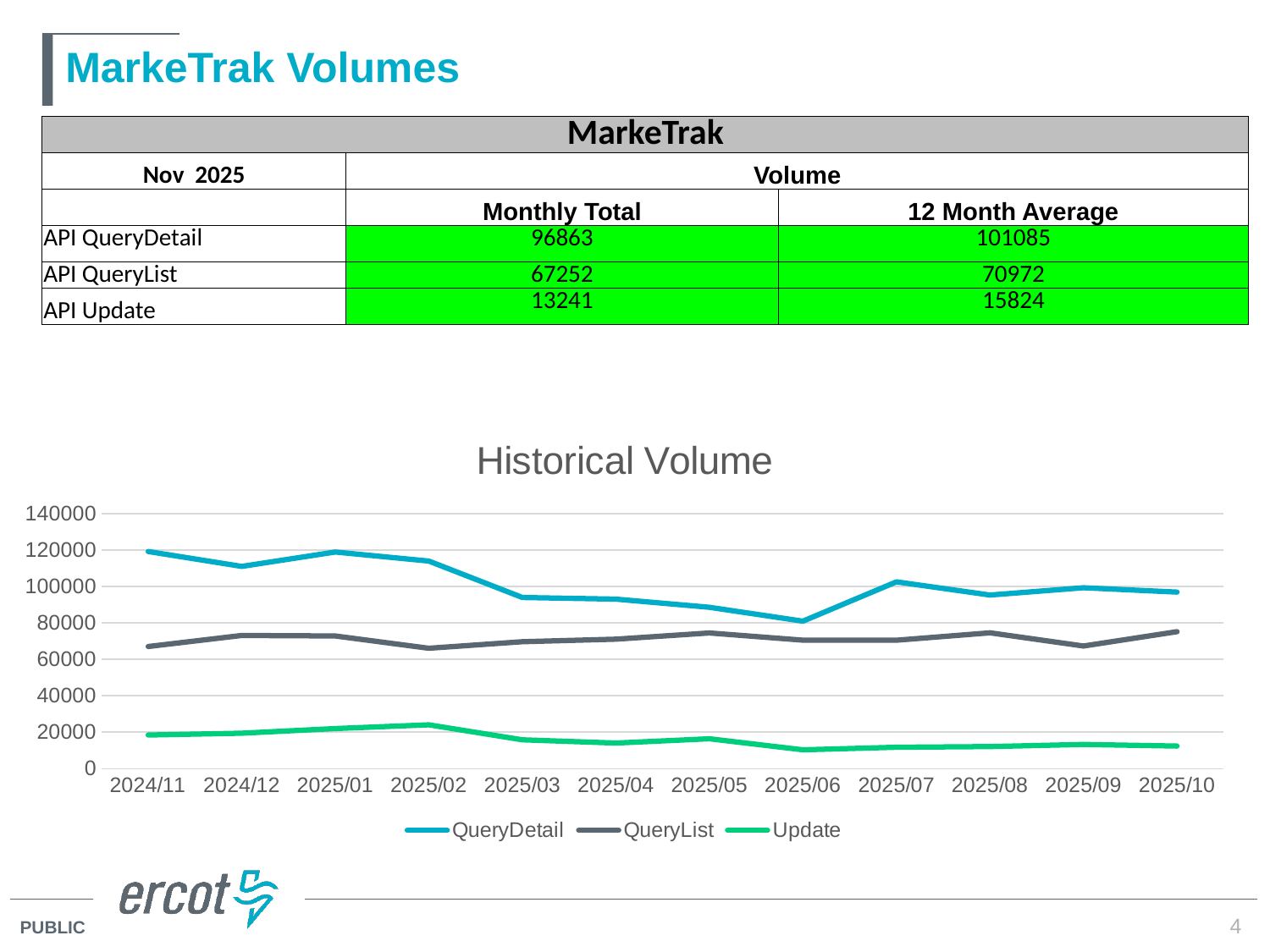
In the Historical Volume chart, is the Update value for 2025/02 greater or less than 20000? greater In the Historical Volume chart, in which month is the QueryDetail series at its lowest? 2025/06 How many months are shown on the x axis of the Historical Volume chart? 12 In the Historical Volume chart, does the QueryDetail series rise or fall from 2025/01 to 2025/06? fall In the Historical Volume chart, is the QueryDetail value for 2025/06 greater or less than 100000? less What kind of chart is the Historical Volume chart? line chart How many series does the legend of the Historical Volume chart list? 3 In the Historical Volume chart, in which month is the Update series at its highest? 2025/02 In the Historical Volume chart, which series has the larger value in 2025/06, QueryDetail or QueryList? QueryDetail In the Historical Volume chart, is the QueryDetail value for 2024/11 greater or less than 100000? greater